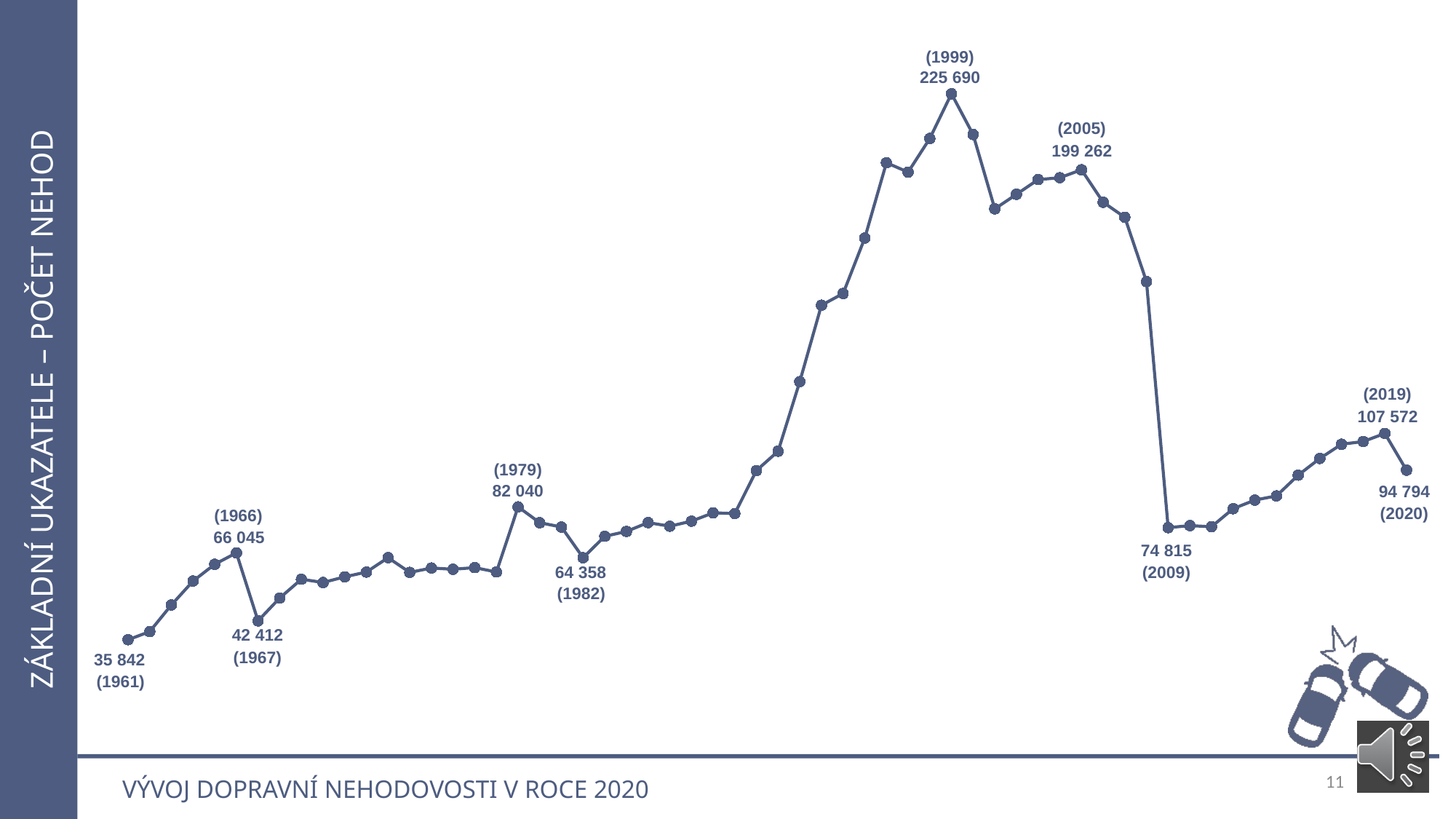
Do the values rise or fall between 2009 and 2019? rise What is the number of accidents labelled for 2020? 94 794 What is the number of accidents labelled for 2009? 74 815 Which year has the highest number of accidents on the chart? 1999 What is the difference between the values for 2019 and 2020? 12 778 What is the number of accidents labelled for 1999? 225 690 What is the number of accidents labelled for 1961? 35 842 Which is larger, the value for 2005 or the value for 2019? 2005 What kind of chart is shown on the slide? line chart What is the difference between the values for 1999 and 2005? 26 428 What is the title written vertically on the left of the slide? ZÁKLADNÍ UKAZATELE – POČET NEHOD Which year has the lowest number of accidents on the chart? 1961